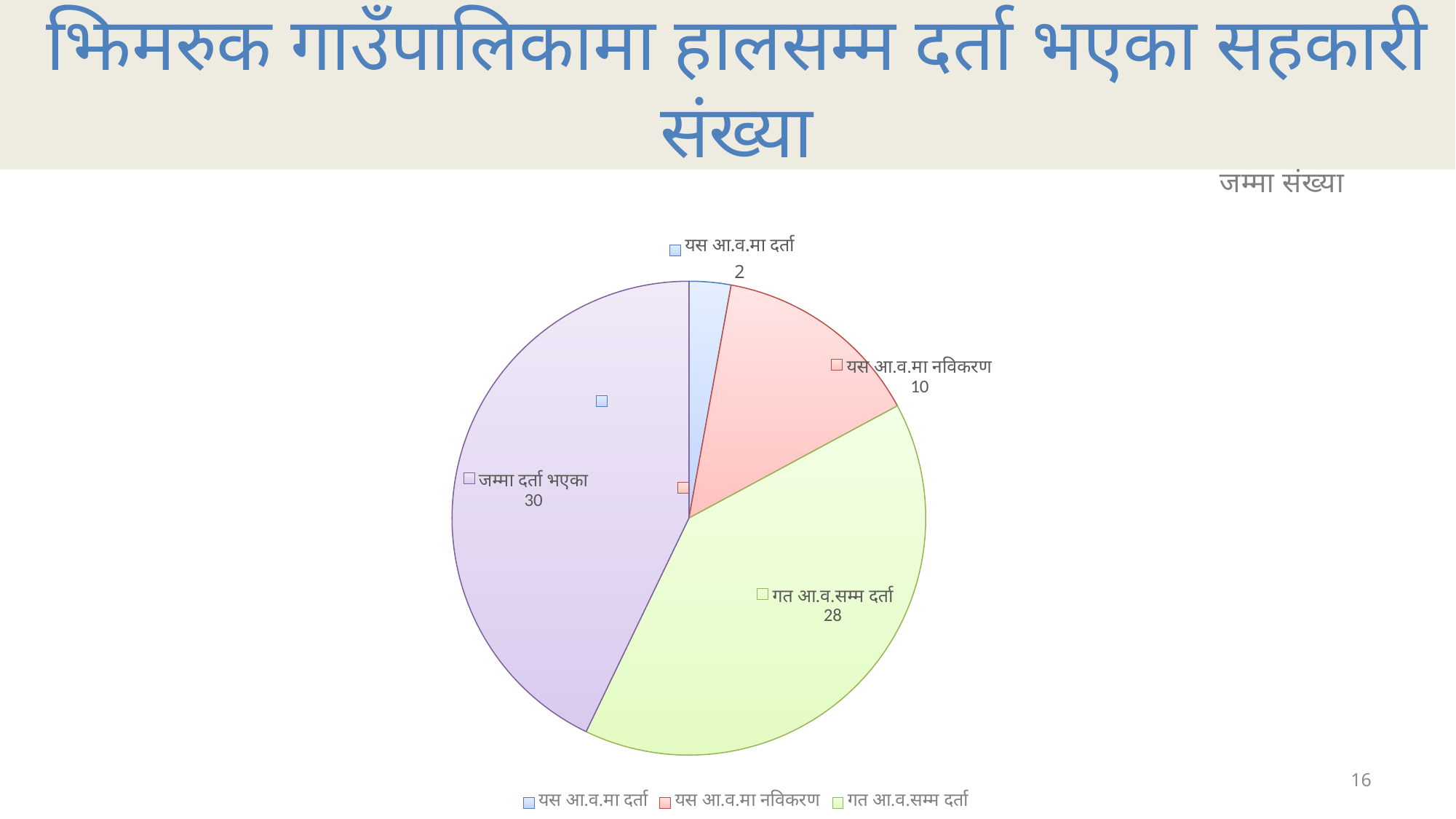
Which slice of the pie is the smallest? यस आ.व.मा दर्ता How many slices does the pie chart have? 4 What is the value for गत आ.व.सम्म दर्ता? 28 Which slice of the pie is the largest? जम्मा दर्ता भएका How many entries does the legend list? 3 What is the value for यस आ.व.मा दर्ता? 2 What is the value for जम्मा दर्ता भएका? 30 What is the title of the chart? जम्मा संख्या What kind of chart is shown on the slide? pie chart What is the value for यस आ.व.मा नविकरण? 10 What is the difference between the values for गत आ.व.सम्म दर्ता and यस आ.व.मा नविकरण? 18 Which is larger, यस आ.व.मा नविकरण or यस आ.व.मा दर्ता? यस आ.व.मा नविकरण